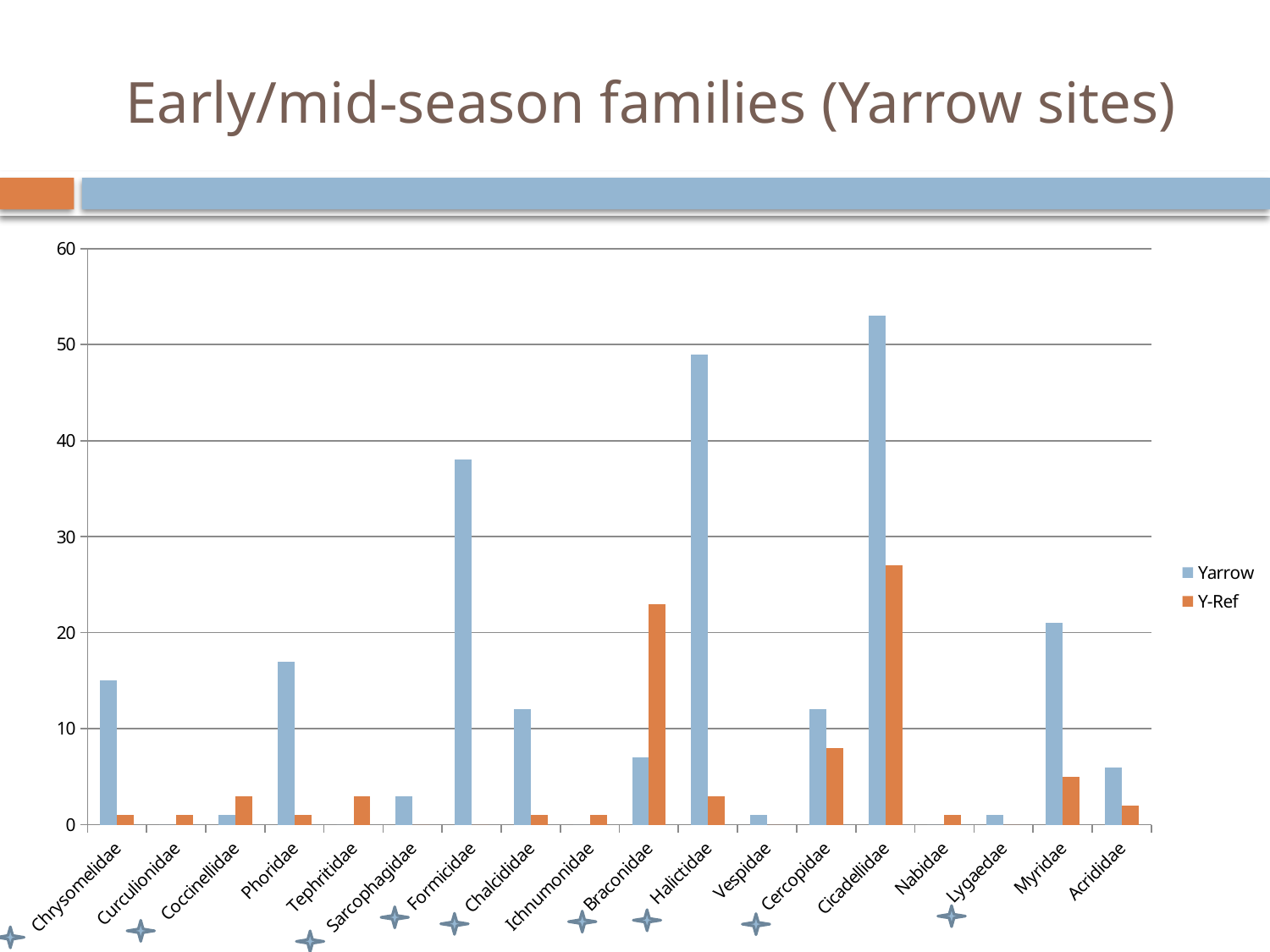
Which is larger: the Yarrow value for Formicidae or the Yarrow value for Myridae? Formicidae For Braconidae, which series has the larger value, Yarrow or Y-Ref? Y-Ref What are the two series named in the legend? Yarrow and Y-Ref What type of chart is shown on the slide? bar chart Is the Yarrow value for Chrysomelidae greater or less than 10? greater Is the Yarrow value for Formicidae greater or less than 30? greater How many series does the legend list? 2 How many families (categories) are shown on the x axis? 18 Which family has the highest Yarrow value? Cicadellidae Is the Y-Ref value for Cicadellidae greater or less than 20? greater Which family has the highest Y-Ref value? Cicadellidae